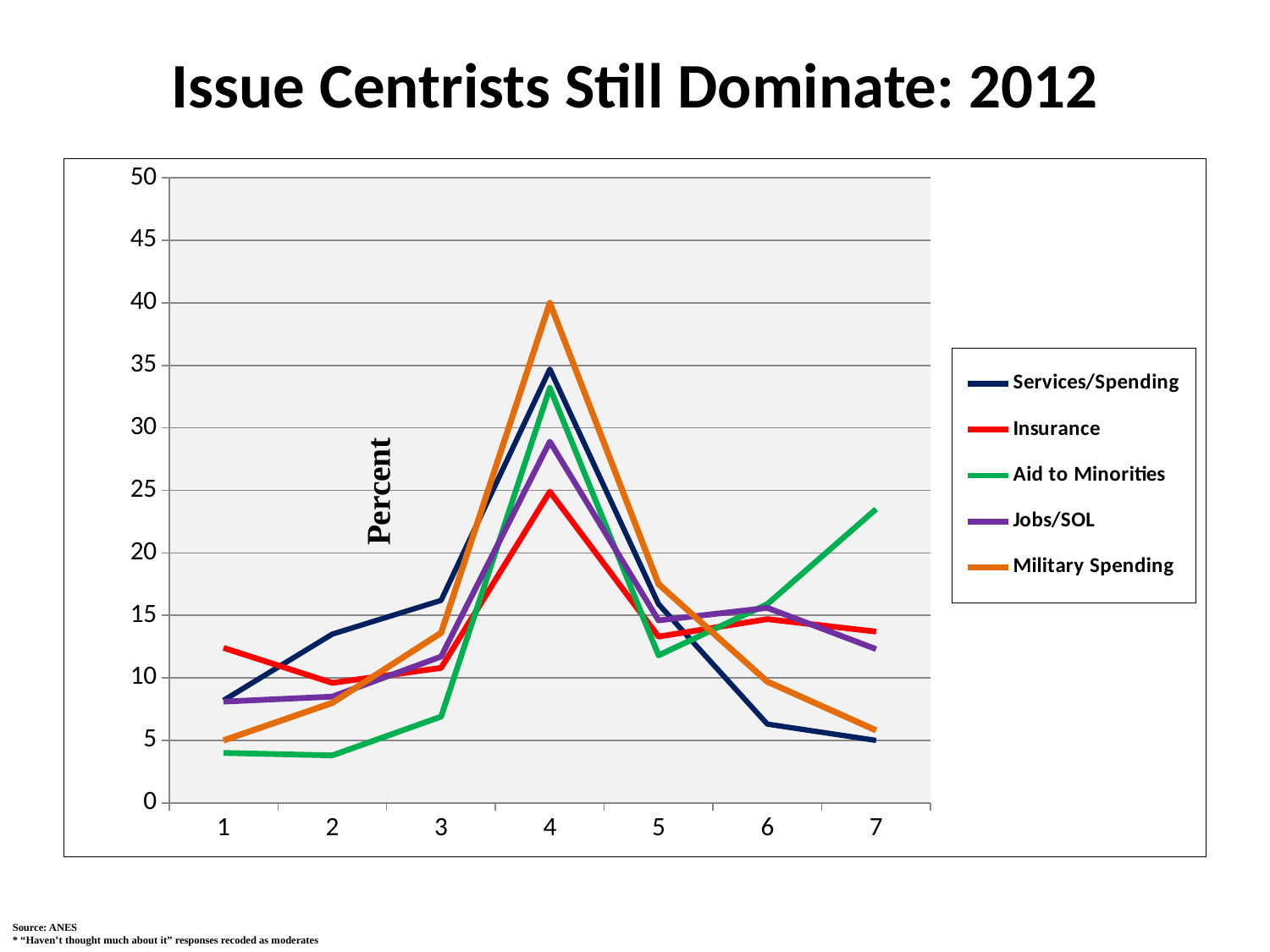
How many series does the legend list? 5 What is the label on the y axis? Percent At x = 7, which is larger: Aid to Minorities or Insurance? Aid to Minorities Is the value for Services/Spending at x = 7 greater or less than 10? less How many points are there along the x axis? 7 What kind of chart is shown on the slide? line chart Is the value for Military Spending at x = 4 greater or less than 35? greater Which series has the highest value at x = 7? Aid to Minorities Does the Services/Spending line rise or fall from x = 4 to x = 7? fall Which series has the lowest value at x = 2? Aid to Minorities Is the value for Insurance at x = 4 greater or less than 20? greater Which series has the highest value at x = 4? Military Spending